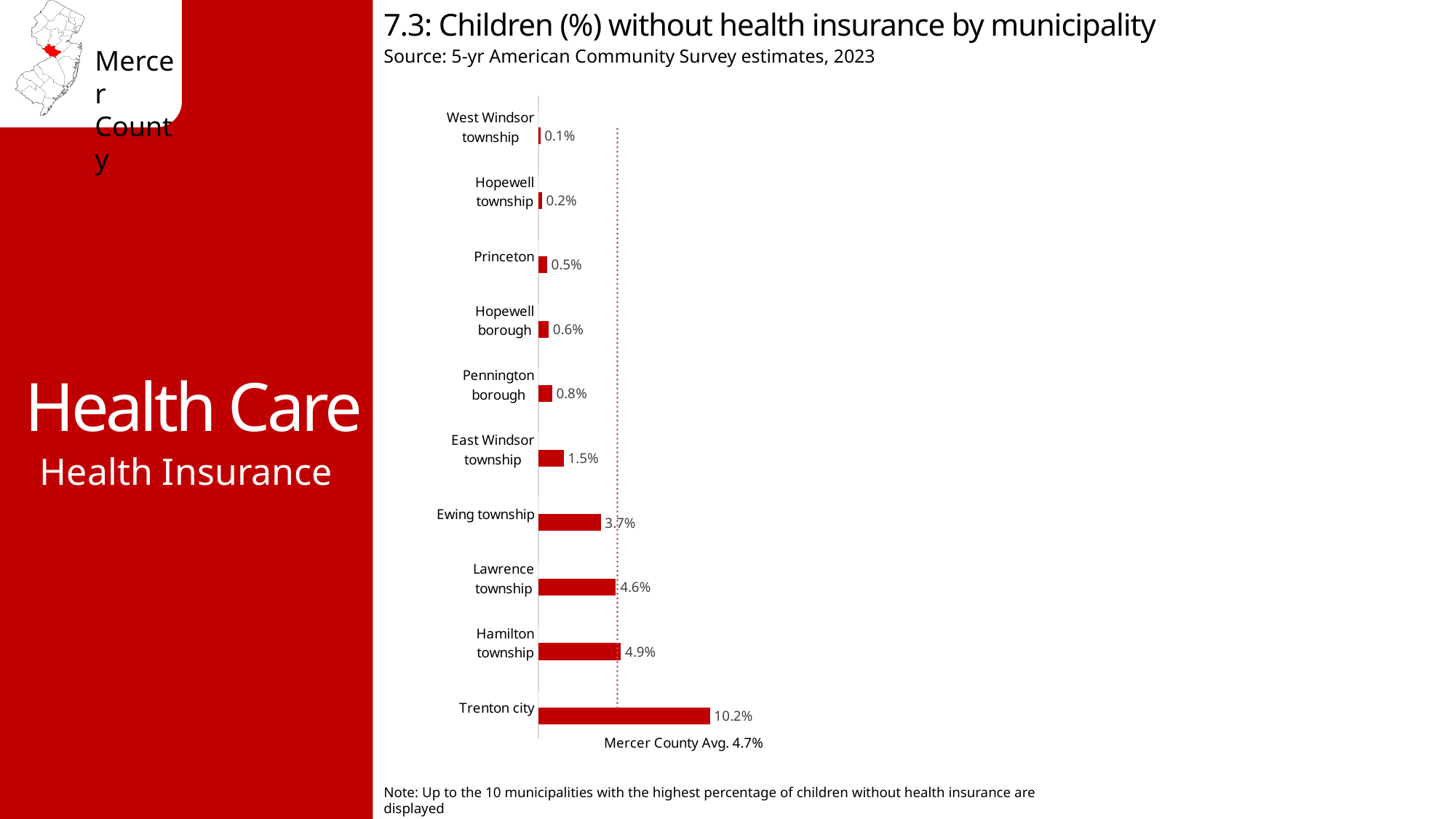
Which has a higher value, Ewing township or Pennington borough? Ewing township What is the difference between the values for Lawrence township and East Windsor township? 3.1% What is the source of the data in the chart? 5-yr American Community Survey estimates, 2023 What is the value shown for Princeton? 0.5% Which municipality has the highest percentage of children without health insurance? Trenton city What kind of chart is shown on the slide? Bar chart Which municipality has the lowest percentage of children without health insurance? West Windsor township What is the difference between the values for Trenton city and Hamilton township? 5.3% What is the Mercer County average shown by the dotted line? 4.7% What percentage of children are without health insurance in Trenton city? 10.2% How many municipalities are shown in the chart? 10 What is the value shown for Ewing township? 3.7%